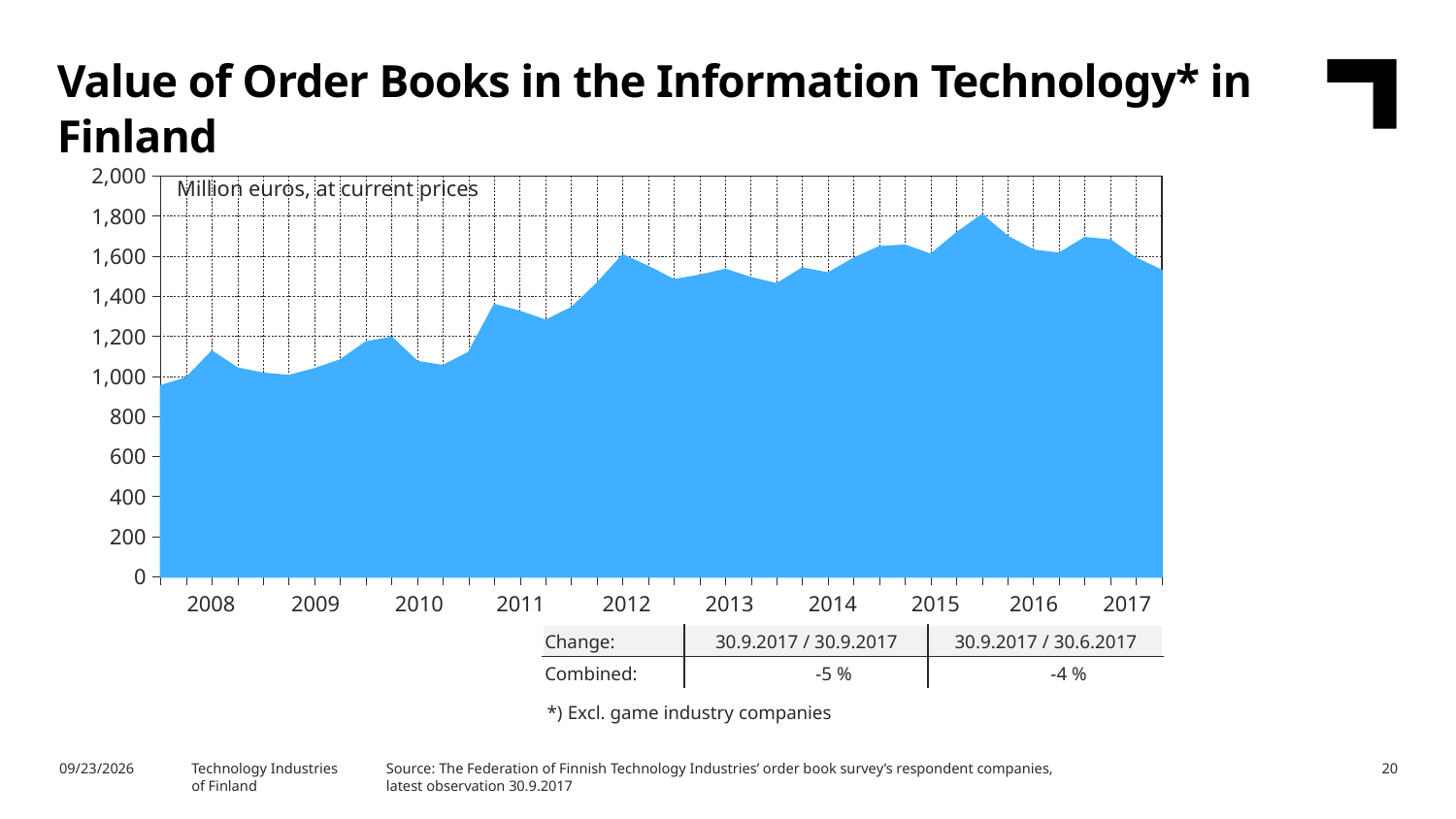
Is the value of order books at the start of 2014 greater or less than 1,400? greater What kind of chart is shown on the slide? area chart Is the value of order books at the start of 2011 greater or less than 1,200? greater In which year does the value of order books reach its highest point? 2015 What unit is the value of order books measured in, according to the label inside the chart? Million euros, at current prices Is the value of order books at the start of 2017 greater or less than 1,600? greater Which is larger, the value of order books at the start of 2010 or at the start of 2012? 2012 Overall, does the value of order books rise or fall from 2008 to 2017? rise How many years are labelled on the x axis of the chart? 10